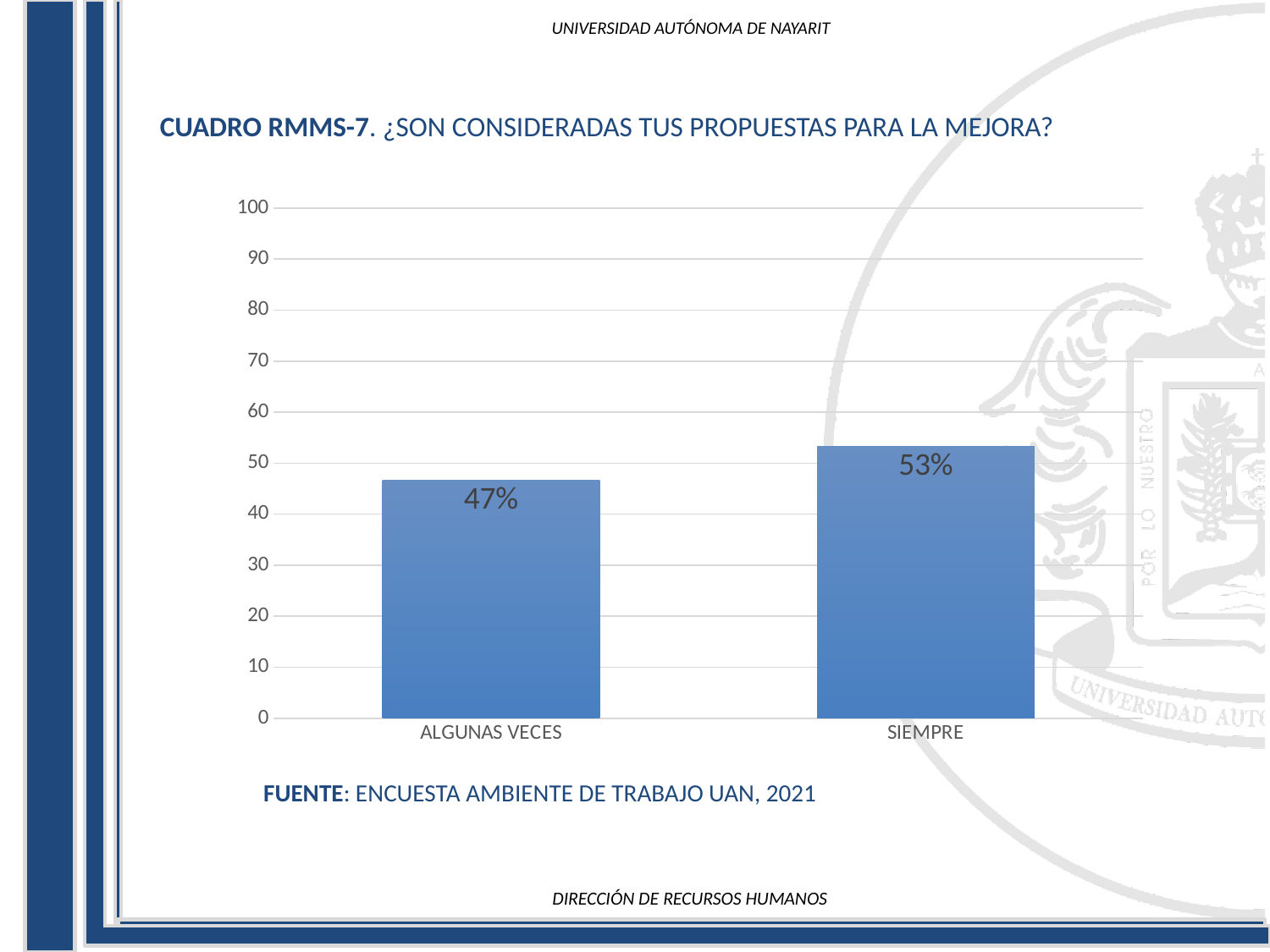
What is the value for SIEMPRE? 53% Which category has the highest value? SIEMPRE Is the value for SIEMPRE greater or less than 50? greater Which category has the lowest value? ALGUNAS VECES What is the title of the chart? CUADRO RMMS-7. ¿SON CONSIDERADAS TUS PROPUESTAS PARA LA MEJORA? What is the difference between the values for SIEMPRE and ALGUNAS VECES? 6% Which is larger, the value for ALGUNAS VECES or the value for SIEMPRE? SIEMPRE Is the value for ALGUNAS VECES greater or less than 50? less How many categories are shown on the x axis? 2 What is the value for ALGUNAS VECES? 47% What is the maximum value shown on the y axis? 100 What kind of chart is shown on the slide? bar chart